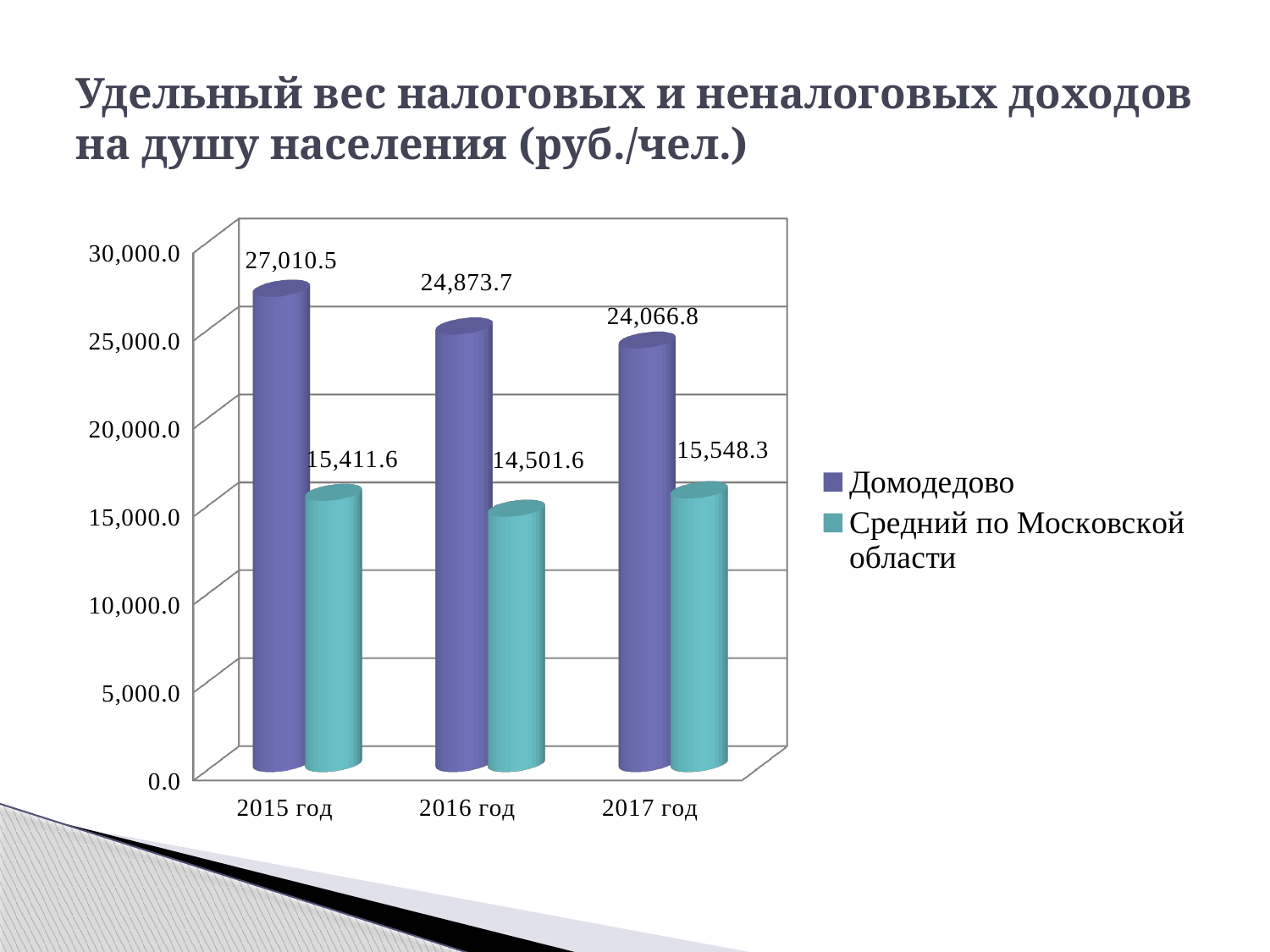
Is the value for Средний по Московской области in 2017 год greater or less than 20,000.0? less What is the value for Средний по Московской области in 2016 год? 14,501.6 What is the difference between the Домодедово value and the Средний по Московской области value in 2015 год? 11,598.9 How many years are shown on the x axis? 3 What is the value for Домодедово in 2017 год? 24,066.8 Which is larger in 2017 год: Домодедово or Средний по Московской области? Домодедово What is the value for Домодедово in 2015 год? 27,010.5 By how much did the Домодедово value fall from 2015 год to 2017 год? 2,943.7 In which year is the Средний по Московской области value lowest? 2016 год Does the Домодедово value rise or fall from 2015 год to 2017 год? fall How many series does the legend list? 2 In which year is the Домодедово value highest? 2015 год